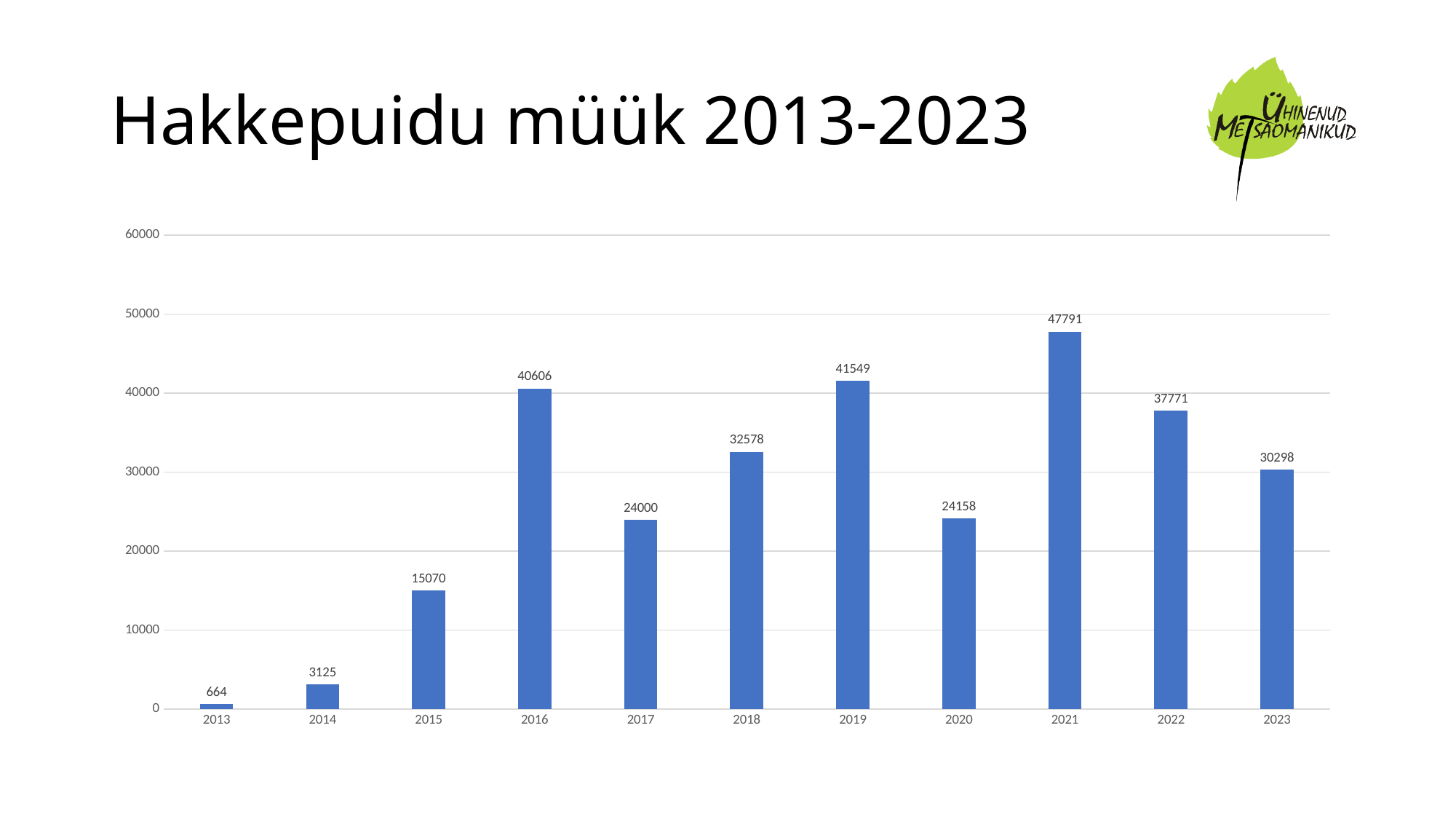
What is the difference between the values for 2021 and 2022? 10020 What is the value for 2013? 664 Do the values rise or fall from 2013 to 2016? rise How many years are shown on the x axis? 11 Which year has the lowest value? 2013 What is the value for 2020? 24158 Is the value for 2019 greater or less than 40000? greater Which year has the highest value? 2021 Which is larger, the value for 2018 or the value for 2023? 2018 What is the title of the slide? Hakkepuidu müük 2013-2023 What is the value for 2016? 40606 What kind of chart is this? bar chart